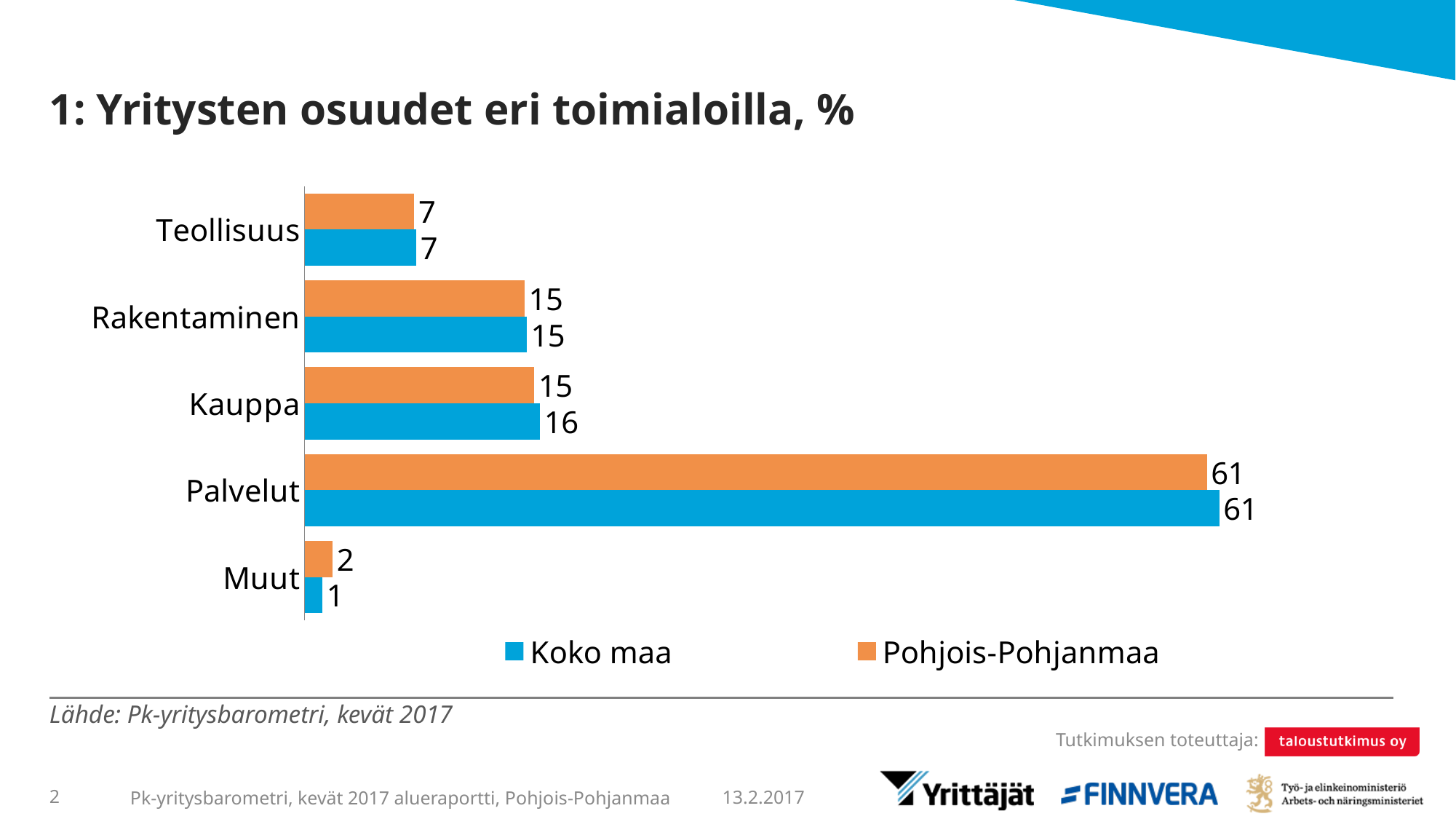
What is the value for Pohjois-Pohjanmaa in the Muut category? 2 How many categories are shown on the chart? 5 What is the title of the chart? 1: Yritysten osuudet eri toimialoilla, % What kind of chart is shown on the slide? Bar chart Which category has the highest value for Koko maa? Palvelut What is the difference between the Palvelut and Kauppa values for Koko maa? 45 Which category has the lowest value for Pohjois-Pohjanmaa? Muut What is the value for Koko maa in the Kauppa category? 16 What is the value for Pohjois-Pohjanmaa in the Palvelut category? 61 Which is larger in the Muut category: Koko maa or Pohjois-Pohjanmaa? Pohjois-Pohjanmaa What is the value for Koko maa in the Teollisuus category? 7 How many series does the legend list? 2